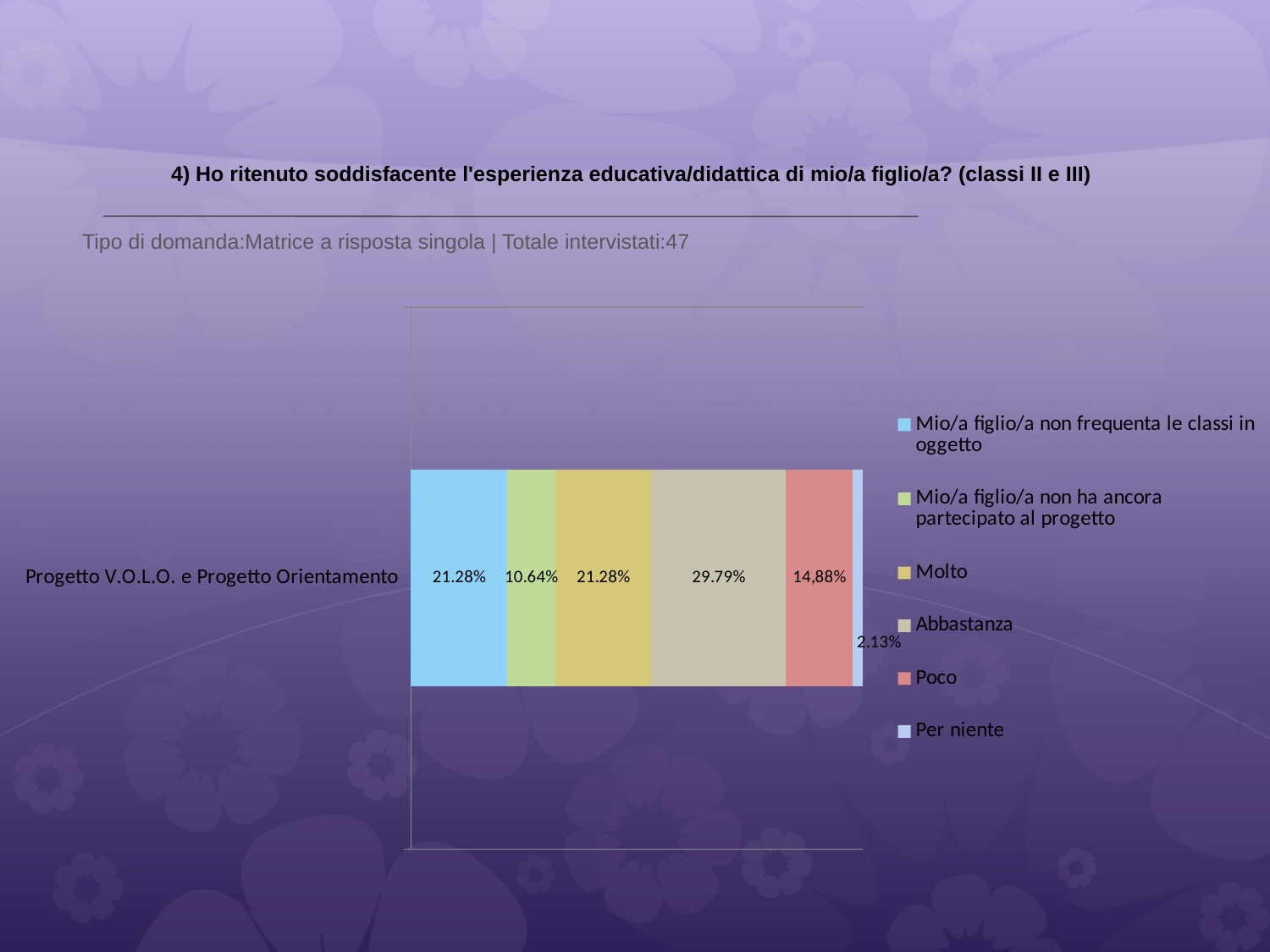
How many series does the legend list? 6 What is the value for 'Abbastanza' for Progetto V.O.L.O. e Progetto Orientamento? 29.79% How many categories are plotted on the chart? 1 What is the difference between the values for 'Abbastanza' and 'Molto'? 8.51% Which series has the lowest value in the bar? Per niente What is the value for 'Per niente' for Progetto V.O.L.O. e Progetto Orientamento? 2.13% What is the value for 'Mio/a figlio/a non ha ancora partecipato al progetto'? 10.64% Which series has the highest value in the bar? Abbastanza What is the value for 'Poco' for Progetto V.O.L.O. e Progetto Orientamento? 14,88% What kind of chart is shown on the slide? Stacked bar chart What is the value for 'Molto' for Progetto V.O.L.O. e Progetto Orientamento? 21.28% Which is larger, the value for 'Abbastanza' or the value for 'Poco'? Abbastanza